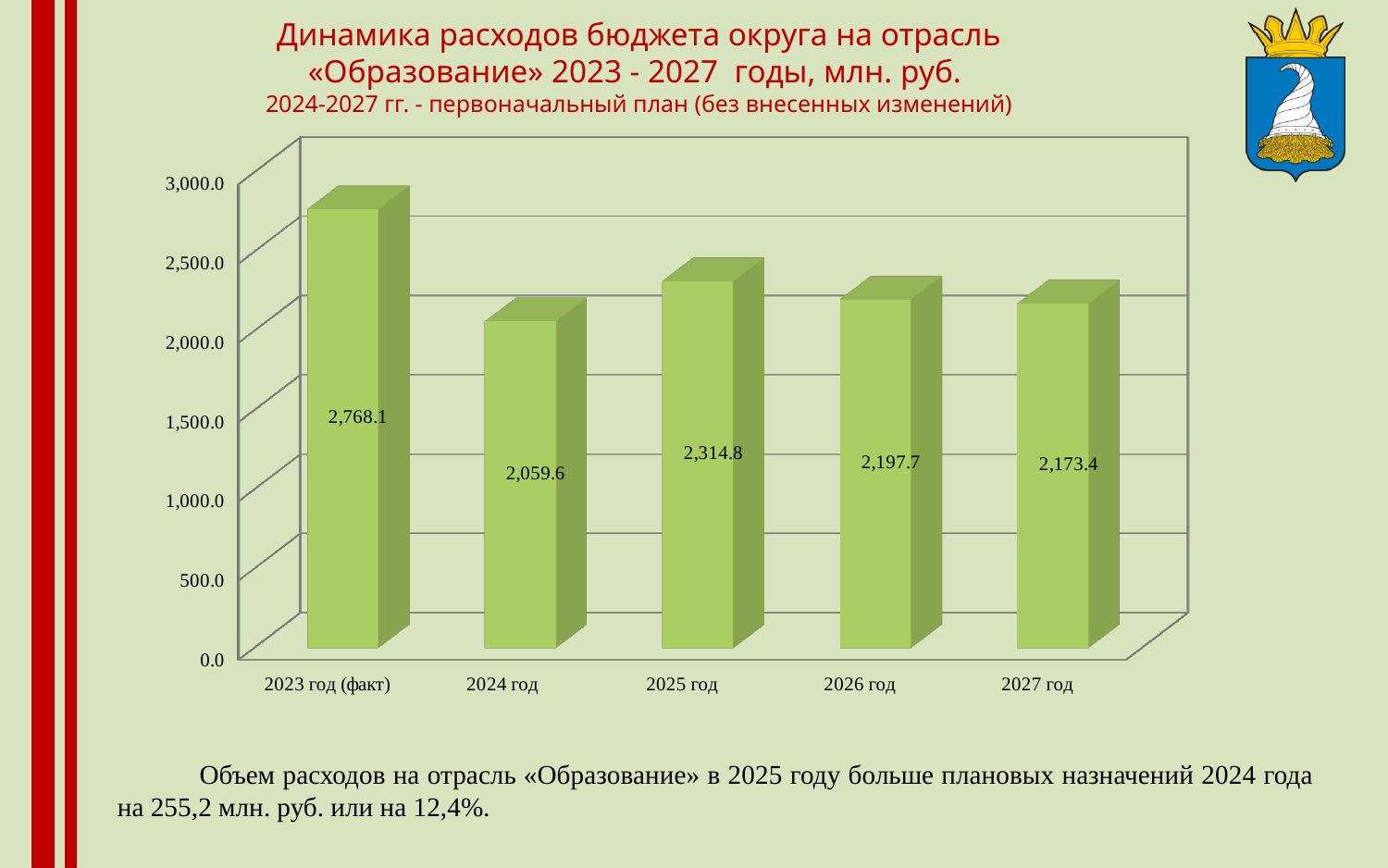
How many bars are shown in the chart? 5 Which year has the highest value? 2023 год (факт) What is the difference between the values for 2023 год (факт) and 2024 год? 708.5 What is the value for 2023 год (факт)? 2,768.1 Is the value for 2024 год greater or less than 2,500.0? less Which year has the lowest value? 2024 год What is the value for 2027 год? 2,173.4 What kind of chart is shown on the slide? bar chart What is the difference between the values for 2025 год and 2024 год? 255.2 Which is larger, the value for 2026 год or the value for 2025 год? 2025 год What is the value for 2025 год? 2,314.8 From 2025 год to 2027 год, do the values rise or fall? fall